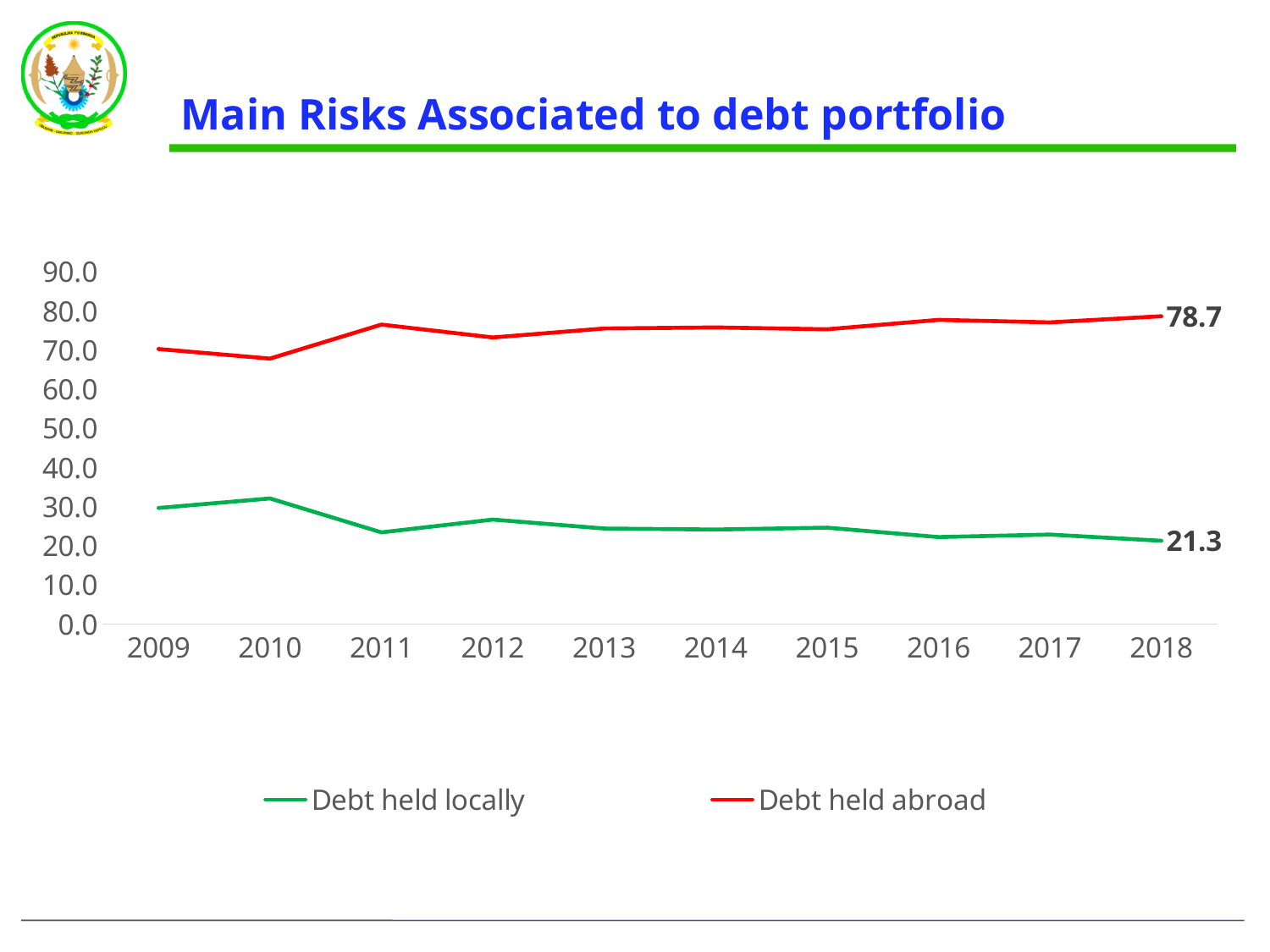
Is the value for Debt held abroad in 2011 greater or less than 70.0? greater What is the value for Debt held locally in 2018? 21.3 Which series has the larger value in 2018, Debt held abroad or Debt held locally? Debt held abroad Is the value for Debt held abroad in 2010 greater or less than 70.0? less In which year is Debt held abroad at its lowest? 2010 What kind of chart is shown on the slide? line chart How many years are shown on the x axis? 10 How many series does the legend list? 2 Is the value for Debt held locally in 2010 greater or less than 30.0? greater In which year is Debt held locally at its highest? 2010 What is the difference between Debt held abroad and Debt held locally in 2018? 57.4 What is the value for Debt held abroad in 2018? 78.7